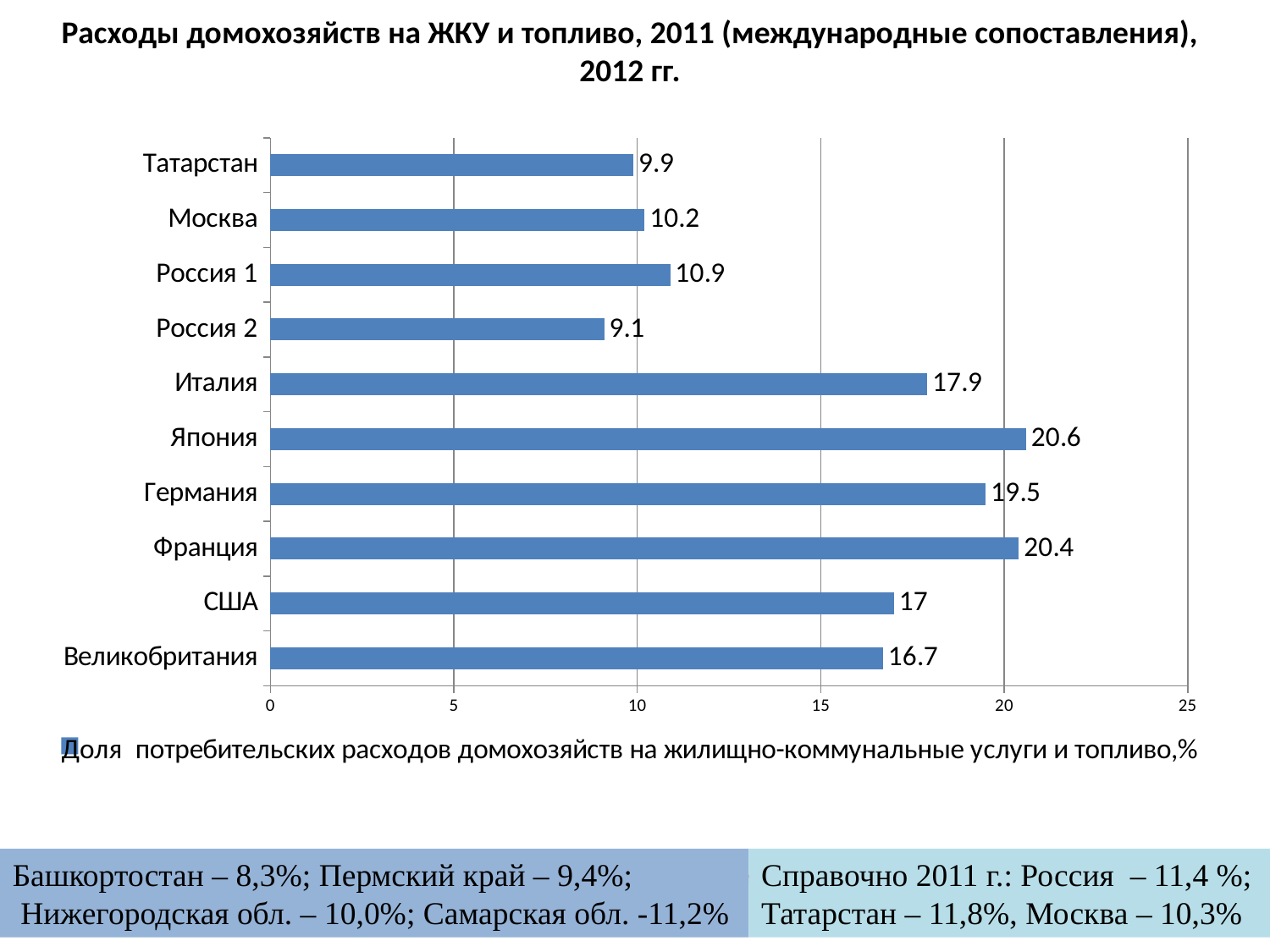
Which category has the highest value? Япония How many series does the legend list? 1 What is the value for Япония? 20.6 What is the value for Россия 2? 9.1 How many categories are shown in the chart? 10 Is the value for Москва greater or less than 15? less What is the value for Великобритания? 16.7 What is the difference between the values for Россия 1 and Татарстан? 1 What is the difference between the values for Германия and Италия? 1.6 What type of chart is shown on the slide? Bar chart Which category has the lowest value? Россия 2 Which is larger, the value for США or the value for Великобритания? США